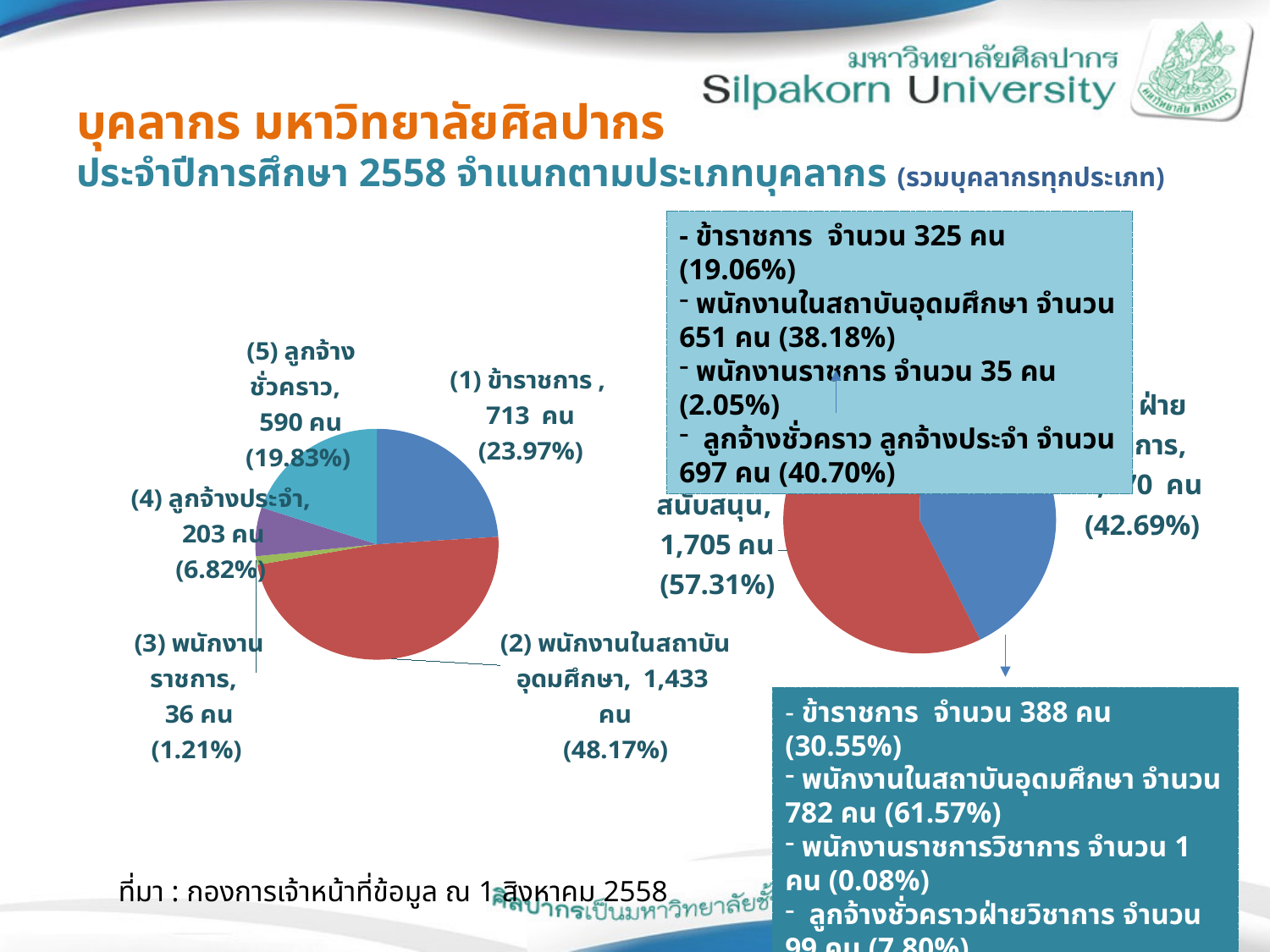
In the left pie chart, what percentage share does (2) พนักงานในสถาบันอุดมศึกษา have? 48.17% In the left pie chart, how many people are in category (1) ข้าราชการ? 713 คน In the left pie chart, what percentage is shown for (4) ลูกจ้างประจำ? 6.82% In the left pie chart, how many categories are shown? 5 In the left pie chart, which category has the largest share? (2) พนักงานในสถาบันอุดมศึกษา In the left pie chart, which category has the smallest share? (3) พนักงานราชการ In the right pie chart, what percentage share does the สนับสนุน slice have? 57.31% In the left pie chart, how many people are in category (5) ลูกจ้างชั่วคราว? 590 คน In the left pie chart, how many people are in category (3) พนักงานราชการ? 36 คน What type of chart is the left chart on the slide? pie chart In the left pie chart, what is the difference in headcount between (1) ข้าราชการ and (5) ลูกจ้างชั่วคราว? 123 คน In the left pie chart, which is larger: (4) ลูกจ้างประจำ or (5) ลูกจ้างชั่วคราว? (5) ลูกจ้างชั่วคราว